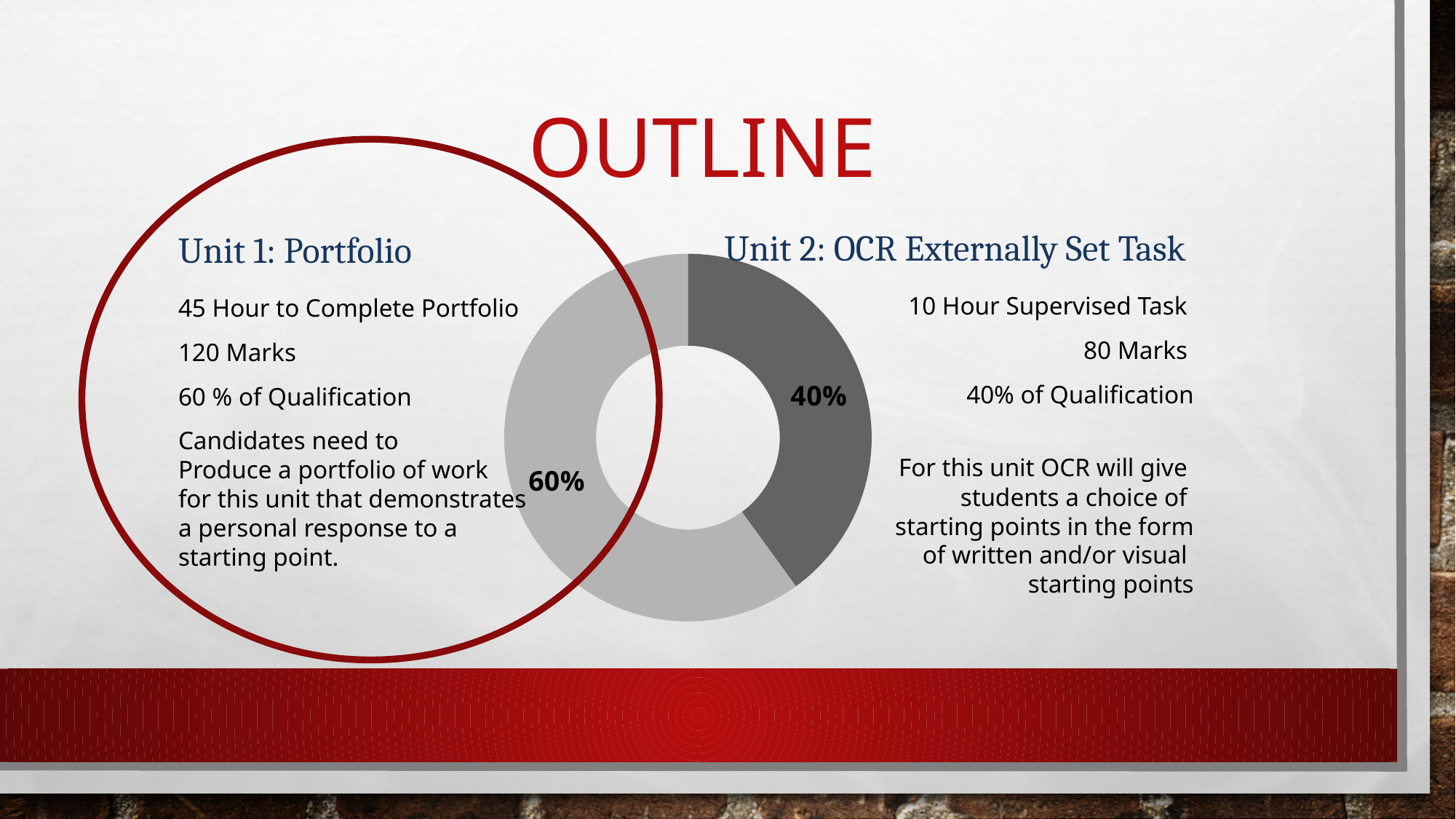
How many slices does the doughnut chart have? 2 What share of the qualification does the doughnut chart show for Unit 1: Portfolio? 60% What value is labelled on the light grey slice of the doughnut chart? 60% Does the doughnut chart have a legend? No What is the difference between the two slice values in the doughnut chart? 20% What share of the qualification does the doughnut chart show for Unit 2: OCR Externally Set Task? 40% What is the value shown on the smaller slice of the doughnut chart? 40% Is the value of the dark grey slice greater or less than 50%? less Which slice is larger in the doughnut chart, the light grey one or the dark grey one? The light grey one What is the value shown on the larger slice of the doughnut chart? 60% What kind of chart is shown on the slide? Doughnut chart What value is labelled on the dark grey slice of the doughnut chart? 40%